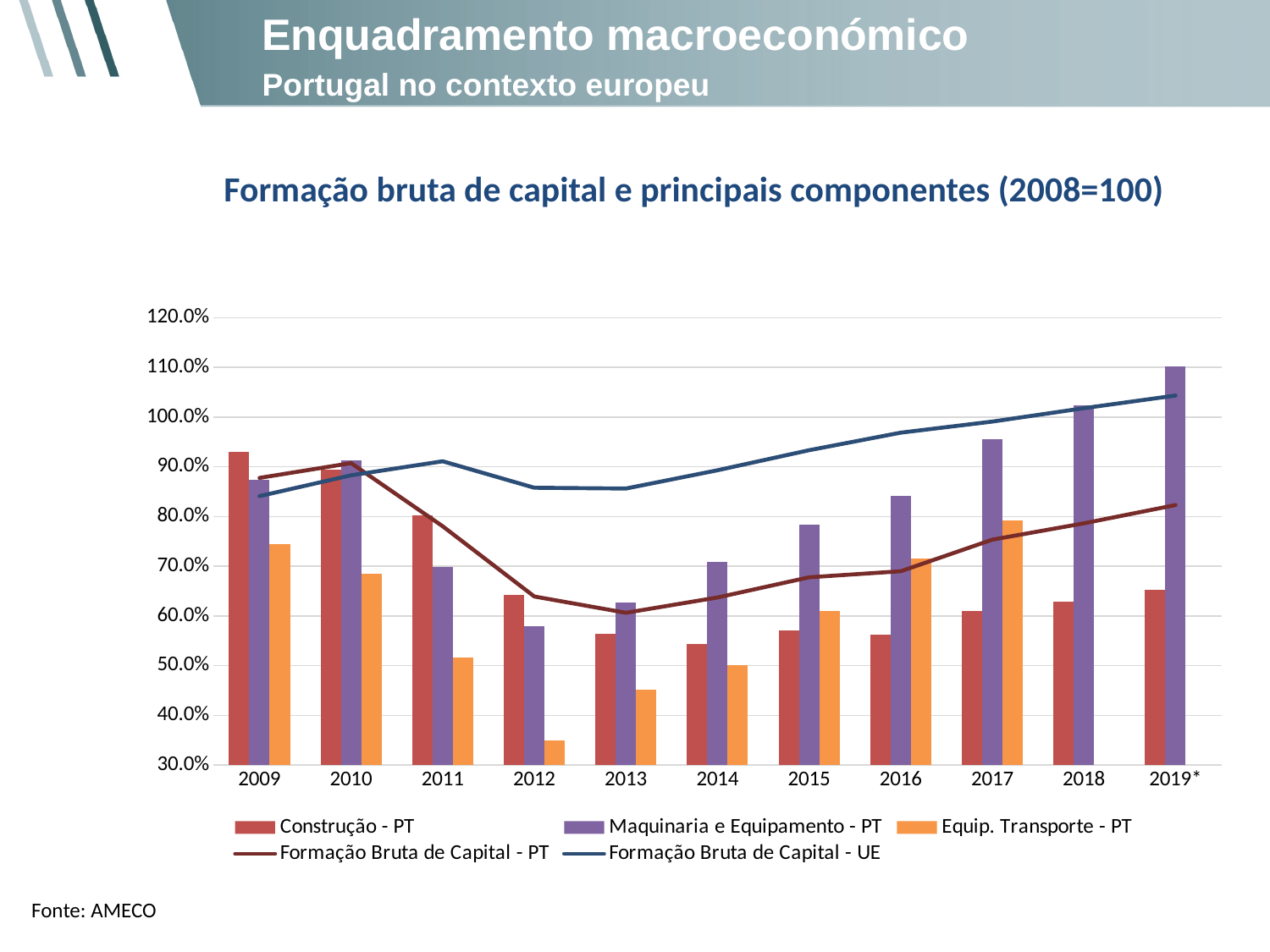
What is the title of the chart? Formação bruta de capital e principais componentes (2008=100) Is the value for Maquinaria e Equipamento - PT in 2019* greater or less than 100.0%? greater In which year is the Construção - PT bar highest? 2009 Does the Formação Bruta de Capital - UE line rise or fall from 2013 to 2019*? Rise In 2009, which is larger: the Construção - PT bar or the Maquinaria e Equipamento - PT bar? Construção - PT In which year is the Maquinaria e Equipamento - PT bar highest? 2019* What kind of chart is shown on the slide? A combined bar and line chart How many years are shown on the x axis? 11 In 2017, which is larger: the Maquinaria e Equipamento - PT bar or the Equip. Transporte - PT bar? Maquinaria e Equipamento - PT How many series does the legend list? 5 Is the value for Construção - PT in 2013 greater or less than 60.0%? less In which year is the Equip. Transporte - PT bar lowest? 2012